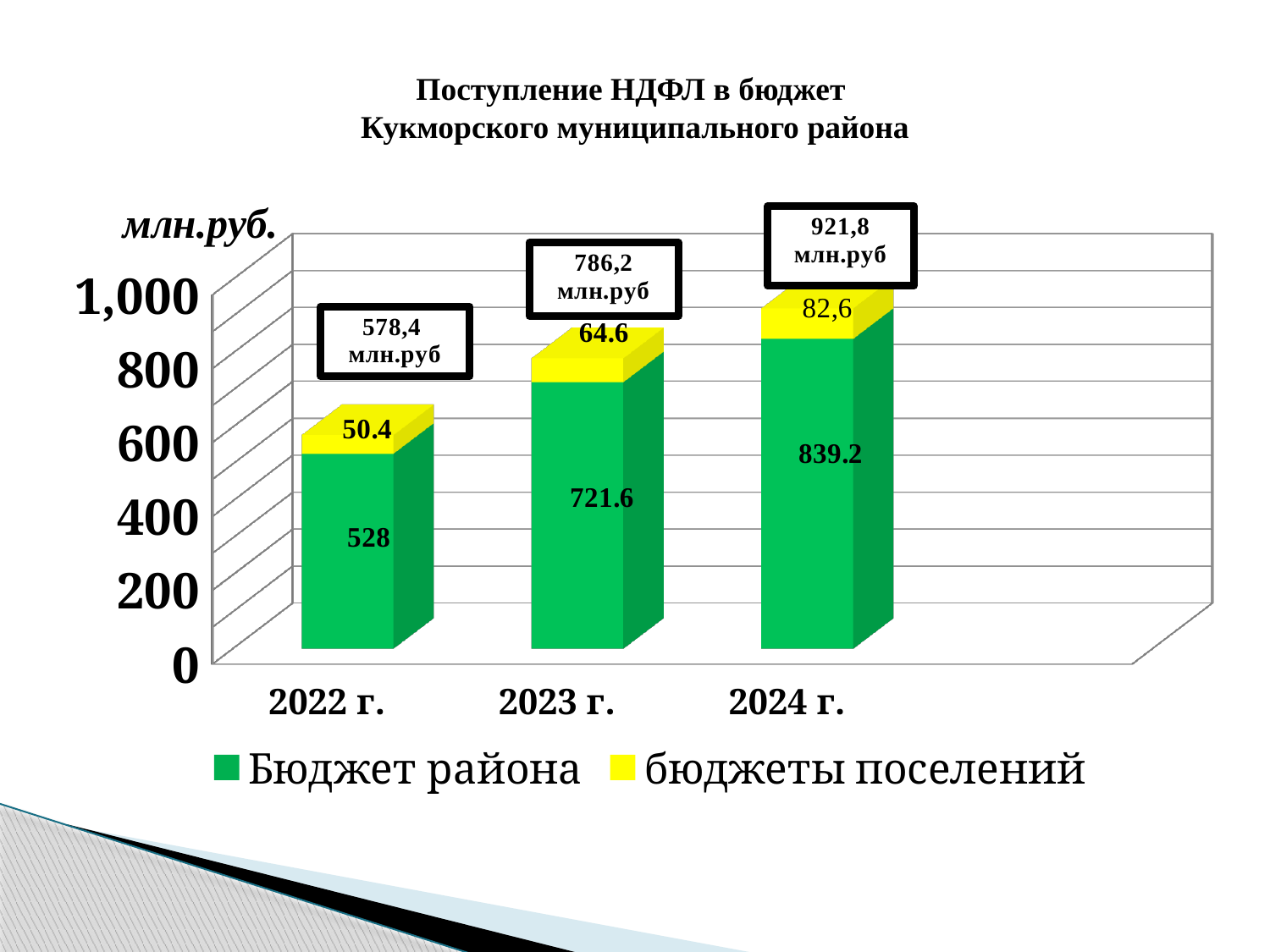
What is the difference between the Бюджет района values for 2023 г. and 2022 г.? 193.6 What is the value of бюджеты поселений for 2024 г.? 82,6 Which is larger: Бюджет района for 2023 г. or Бюджет района for 2024 г.? Бюджет района for 2024 г. Which year has the highest value for Бюджет района? 2024 г. How many series does the legend list? 2 What is the value of Бюджет района for 2024 г.? 839.2 What is the value of бюджеты поселений for 2023 г.? 64.6 Which year has the lowest value for бюджеты поселений? 2022 г. What is the total shown for the 2023 г. bar? 786,2 млн.руб What is the total shown for the 2022 г. bar? 578,4 млн.руб Do the total values rise or fall from 2022 г. to 2024 г.? rise What is the value of Бюджет района for 2022 г.? 528